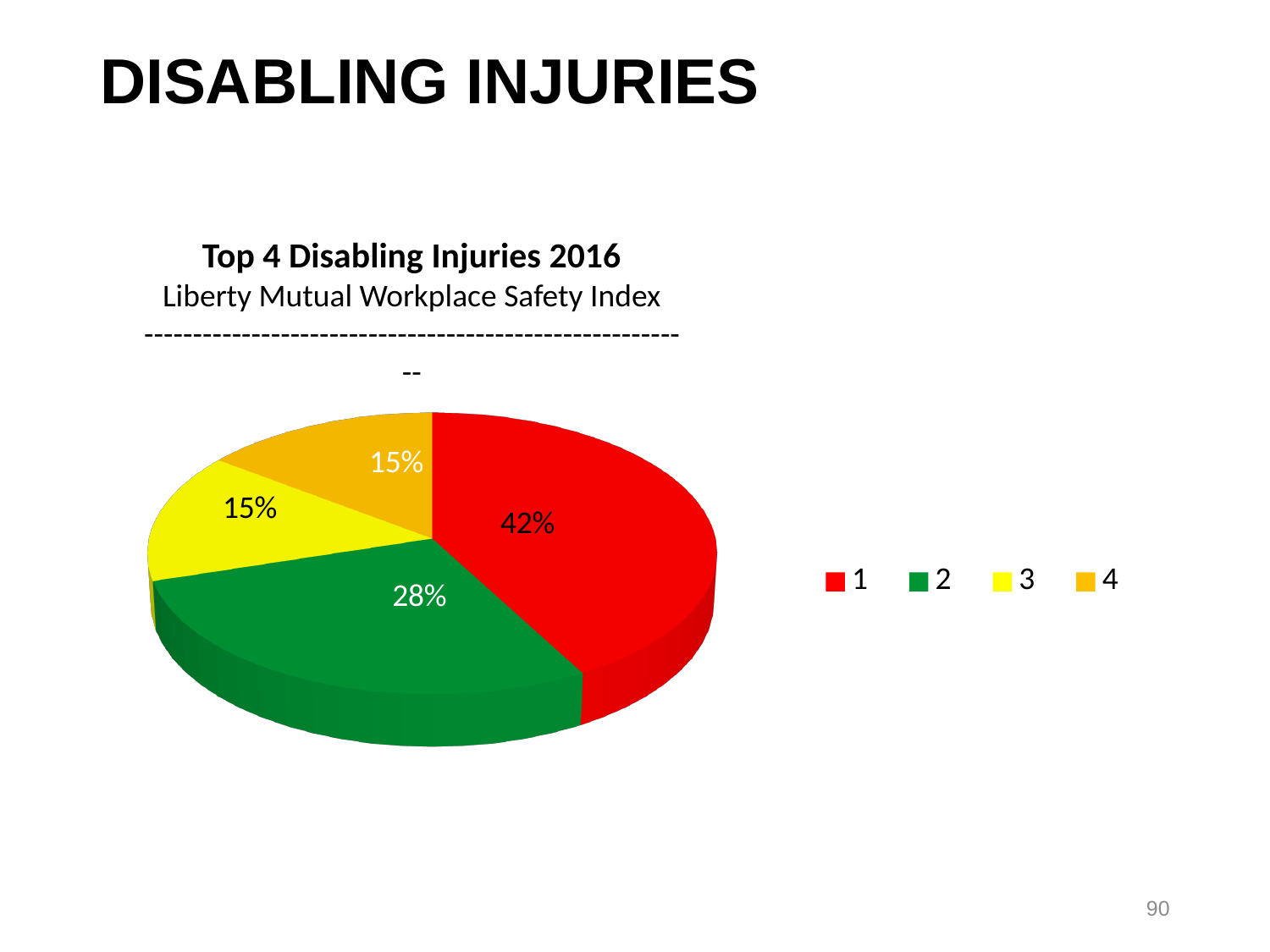
What kind of chart is shown on the slide? pie chart What is the title of the chart? Top 4 Disabling Injuries 2016 Which is larger, the slice for category 2 or the slice for category 3? 2 What share of the pie does category 4 have? 15% What share of the pie does category 2 have? 28% Which category has the largest slice of the pie? 1 What share of the pie does category 3 have? 15% How many slices does the pie chart have? 4 What is the difference in percentage points between category 1 and category 2? 14 How many entries does the legend list? 4 What colour is the slice for category 2? green